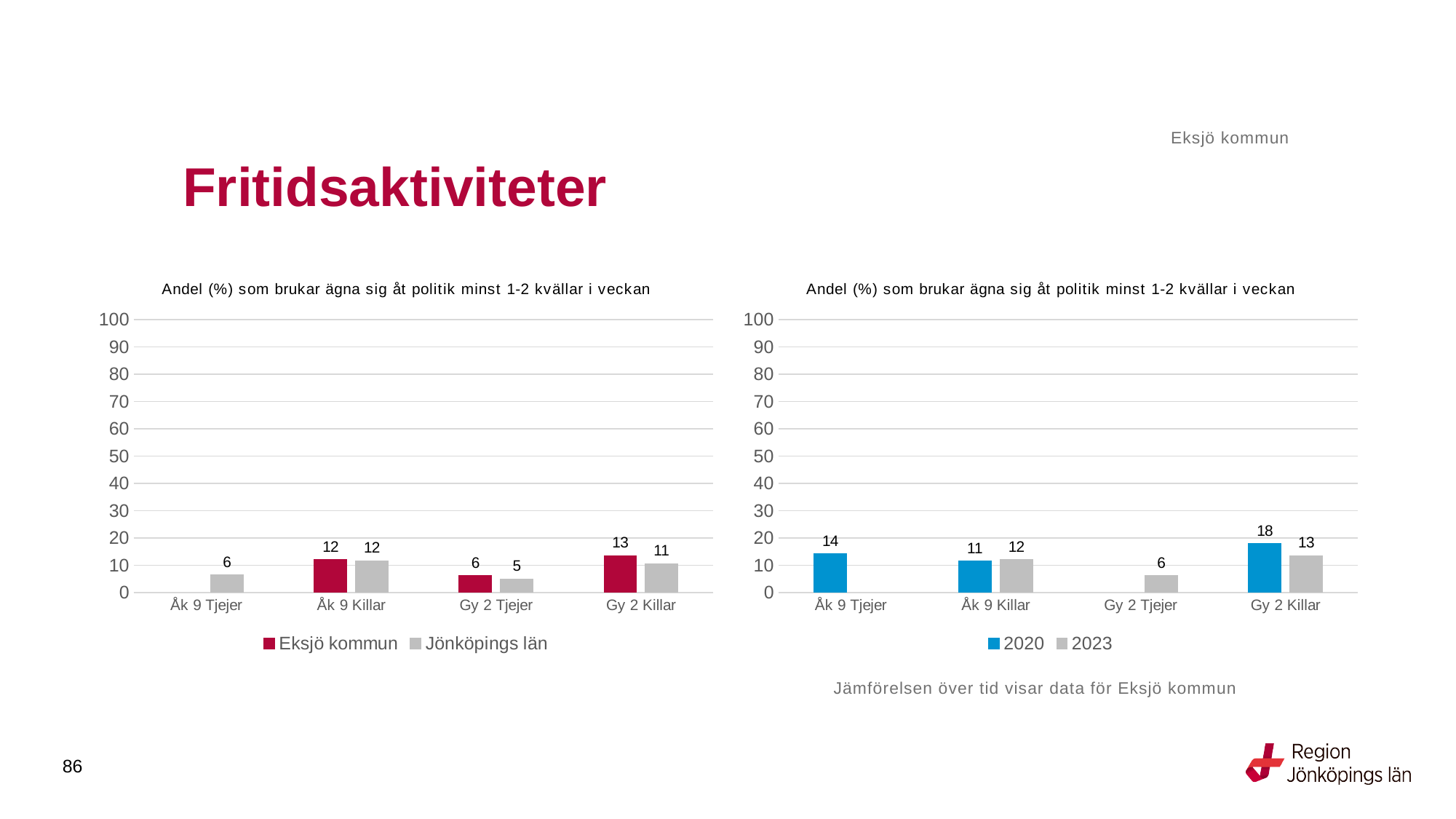
In the left chart, what is the value for Eksjö kommun for Gy 2 Killar? 13 In the right chart, what is the value for 2020 for Gy 2 Killar? 18 In the right chart, what is the value for 2023 for Gy 2 Tjejer? 6 In the left chart, how many series does the legend list? 2 In the left chart, which category has the highest value for Jönköpings län? Åk 9 Killar In the right chart, is the value for 2020 for Åk 9 Tjejer greater or less than 20? less In the left chart, what is the value for Jönköpings län for Gy 2 Tjejer? 5 In the right chart, which is larger for Åk 9 Killar, 2020 or 2023? 2023 In the right chart, which category has the highest value for 2020? Gy 2 Killar What kind of chart is the right chart? bar chart In the right chart, what is the difference between 2020 and 2023 for Gy 2 Killar? 5 In the left chart, what is the difference between Eksjö kommun and Jönköpings län for Gy 2 Killar? 2